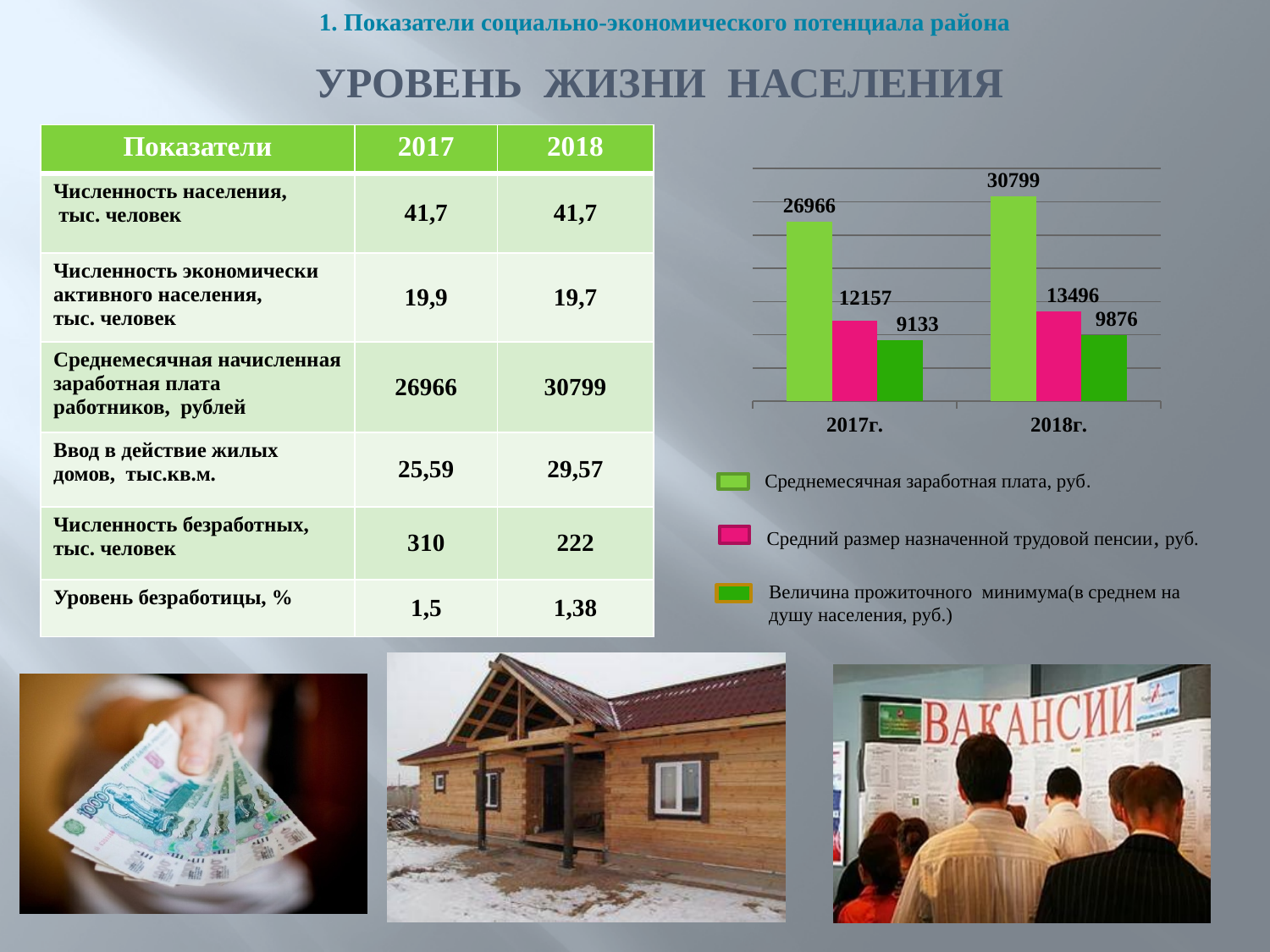
What is the value of Средний размер назначенной трудовой пенсии for 2018г.? 13496 By how much did Среднемесячная заработная плата increase from 2017г. to 2018г.? 3833 Does Среднемесячная заработная плата rise or fall from 2017г. to 2018г.? rise What is the value of Величина прожиточного минимума for 2017г.? 9133 What is the value of Среднемесячная заработная плата for 2018г.? 30799 Is Величина прожиточного минимума higher in 2017г. or in 2018г.? 2018г. Which series has the lowest value in 2018г.? Величина прожиточного минимума What type of chart is shown on the slide? bar chart What is the value of Среднемесячная заработная плата for 2017г.? 26966 What is the difference between Средний размер назначенной трудовой пенсии and Величина прожиточного минимума in 2017г.? 3024 How many categories are shown on the x axis of the chart? 2 How many series does the chart legend list? 3